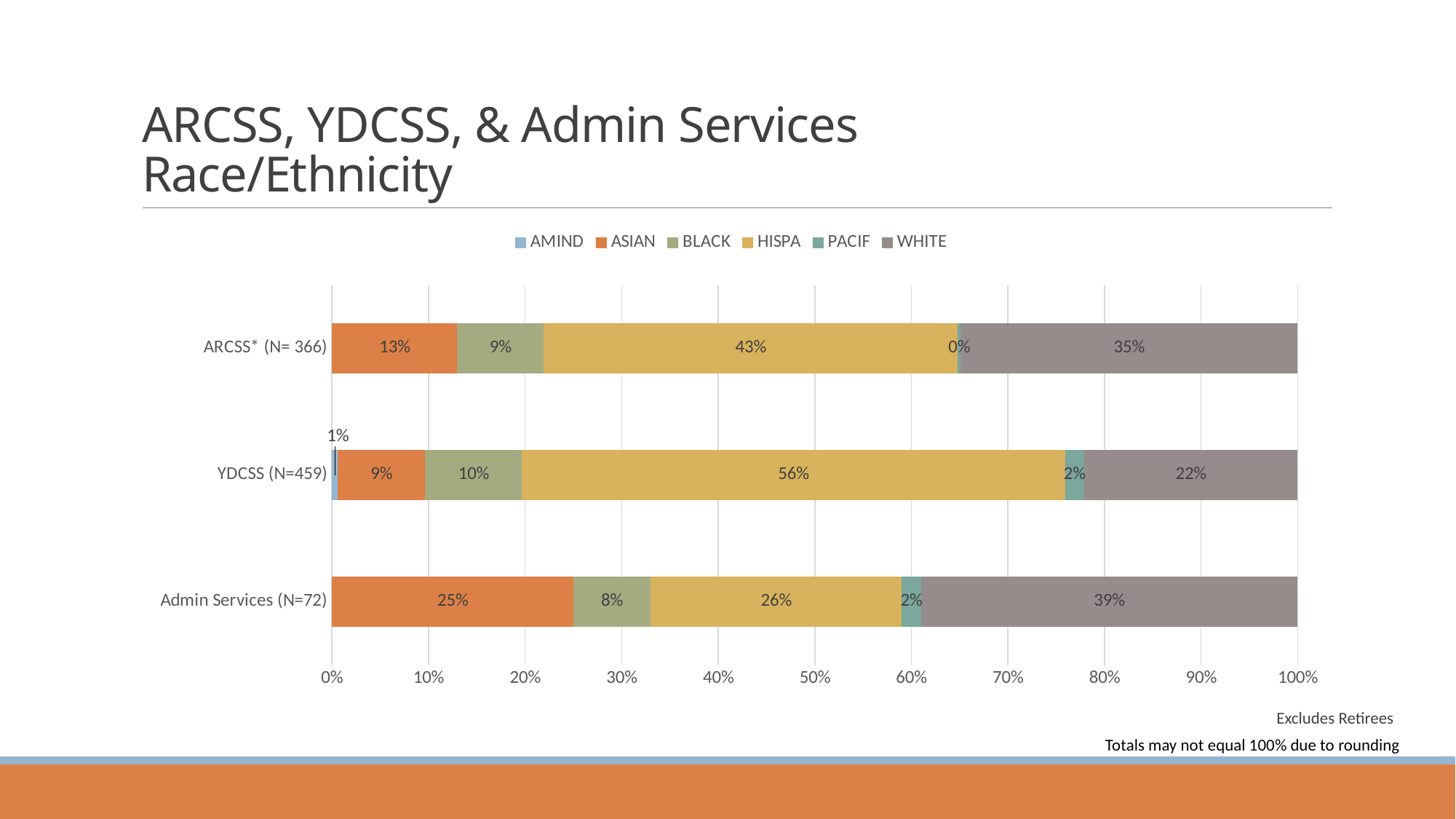
Which group has the highest HISPA share? YDCSS (N=459) Which group has the lowest WHITE share? YDCSS (N=459) What is the PACIF share for ARCSS* (N= 366)? 0% What is the WHITE share for Admin Services (N=72)? 39% How many groups (bars) are shown on the chart? 3 What is the HISPA share for YDCSS (N=459)? 56% Which is larger: the BLACK share for YDCSS (N=459) or the BLACK share for Admin Services (N=72)? YDCSS (N=459) What is the ASIAN share for ARCSS* (N= 366)? 13% What is the AMIND share for YDCSS (N=459)? 1% What is the difference between the ASIAN share for Admin Services (N=72) and the ASIAN share for ARCSS* (N= 366)? 12% What kind of chart is shown on the slide? Stacked bar chart How many series does the legend list? 6